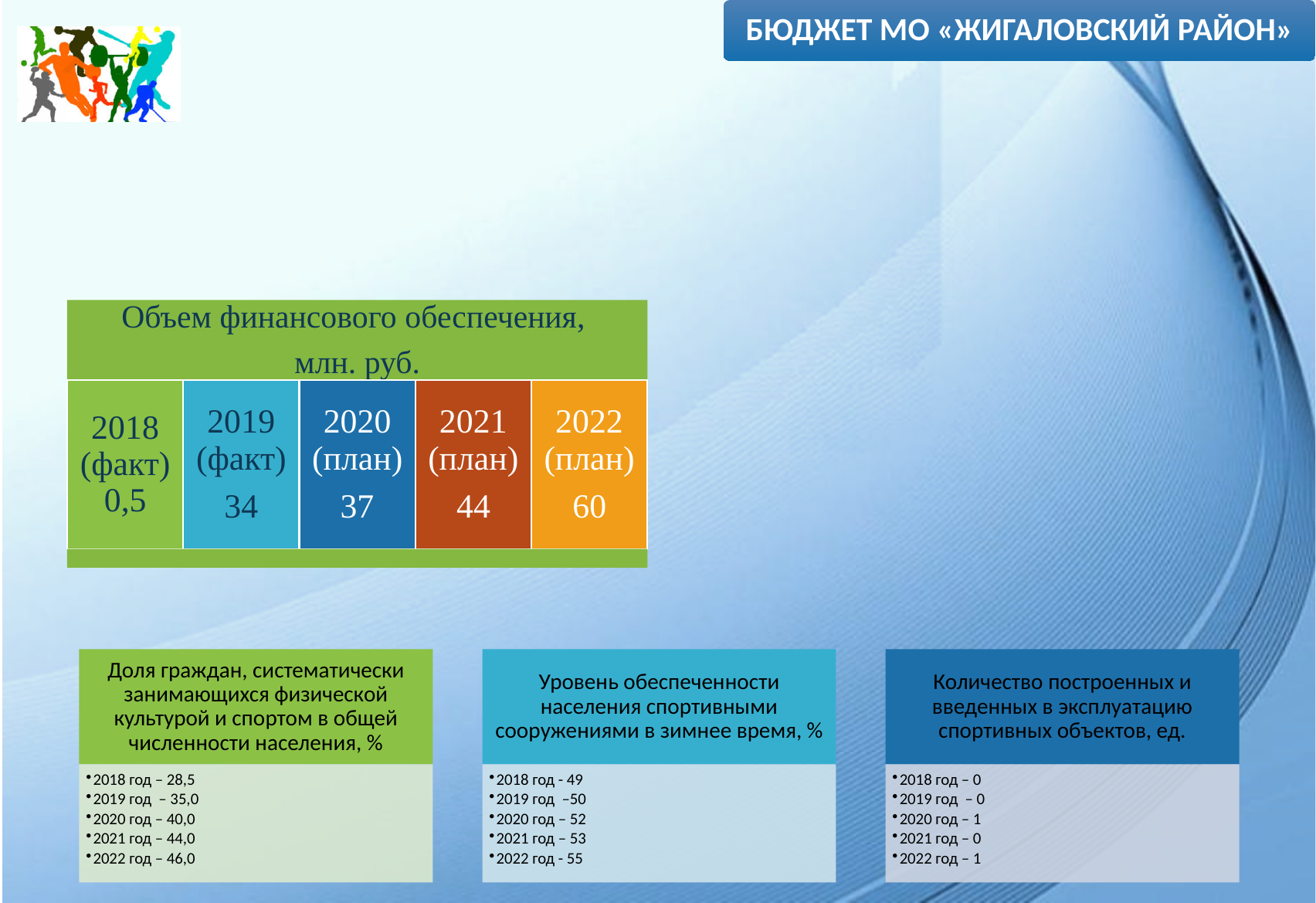
In the 'Объем финансового обеспечения, млн. руб.' chart, what is the value for 2018 (факт)? 0,5 How many years are shown in the 'Объем финансового обеспечения, млн. руб.' chart? 5 In the 'Объем финансового обеспечения, млн. руб.' chart, what is the value for 2020 (план)? 37 What unit is given in the title of the 'Объем финансового обеспечения' chart? млн. руб. In the 'Объем финансового обеспечения, млн. руб.' chart, which year has the highest value? 2022 (план) In the 'Объем финансового обеспечения, млн. руб.' chart, what is the difference between the 2020 (план) and 2019 (факт) values? 3 In the 'Объем финансового обеспечения, млн. руб.' chart, do the values rise or fall from 2018 to 2022? rise In the 'Объем финансового обеспечения, млн. руб.' chart, which year has the lowest value? 2018 (факт) In the 'Объем финансового обеспечения, млн. руб.' chart, how many years are marked as 'план'? 3 In the 'Объем финансового обеспечения, млн. руб.' chart, which is larger: the value for 2021 (план) or 2019 (факт)? 2021 (план) In the 'Объем финансового обеспечения, млн. руб.' chart, what is the value for 2022 (план)? 60 In the 'Объем финансового обеспечения, млн. руб.' chart, what is the difference between the 2022 (план) and 2021 (план) values? 16